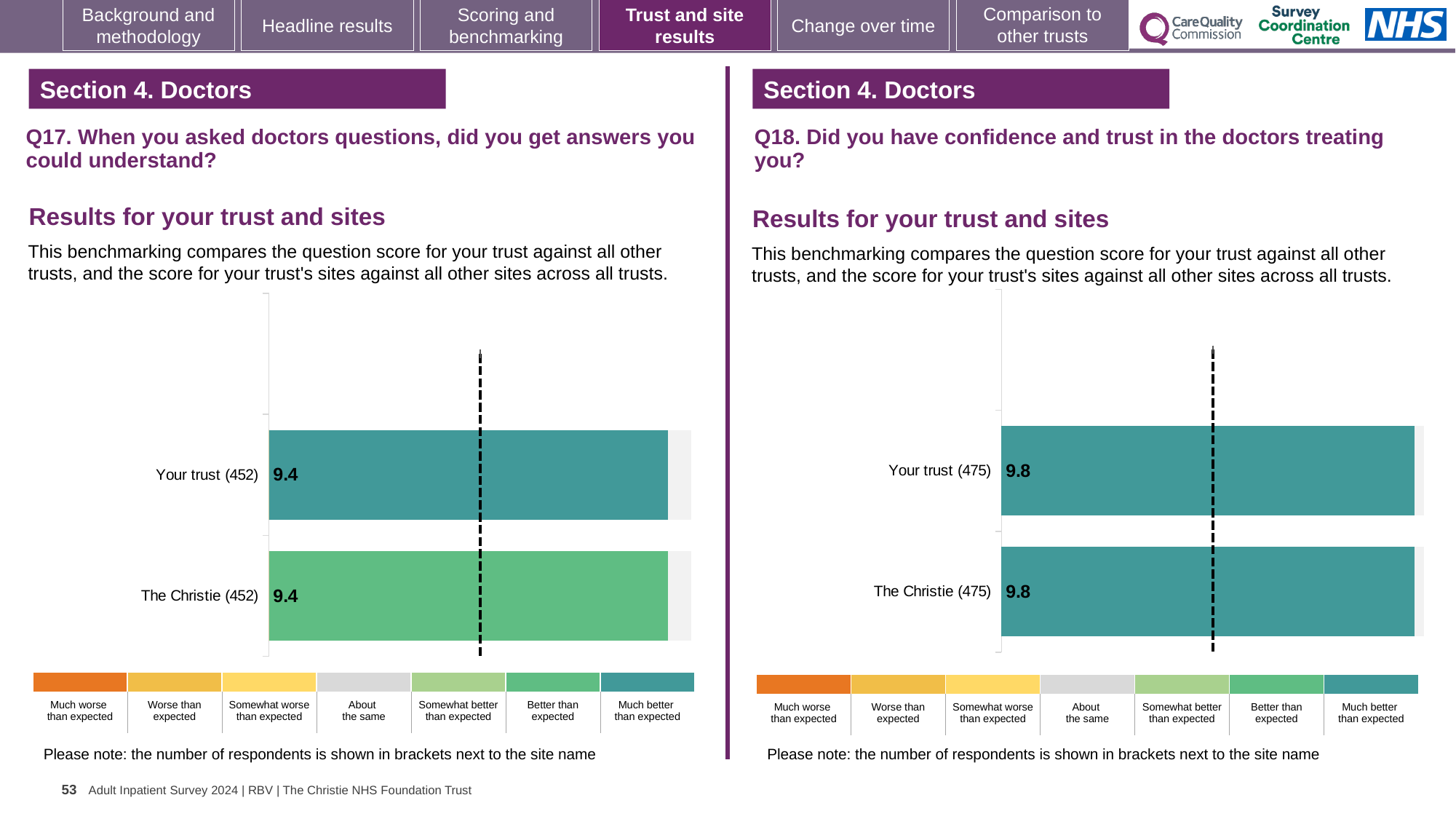
In the Q17 chart on the left, what is the difference between the score for Your trust and the score for The Christie? 0 In the Q18 chart on the right, how many respondents are shown in brackets for Your trust? 475 In the Q18 chart on the right, what is the score for The Christie? 9.8 In the Q17 chart on the left, what is the score for The Christie? 9.4 In the Q17 chart on the left, how many respondents are shown in brackets for The Christie? 452 What kind of chart is used in the Q17 chart on the left? Bar chart Is the score for Your trust in the Q18 chart on the right higher than, lower than, or equal to the score for The Christie in the same chart? Equal How many bars are plotted in the Q18 chart on the right? 2 In the Q18 chart on the right, what is the score for Your trust? 9.8 In the Q17 chart on the left, what is the score for Your trust? 9.4